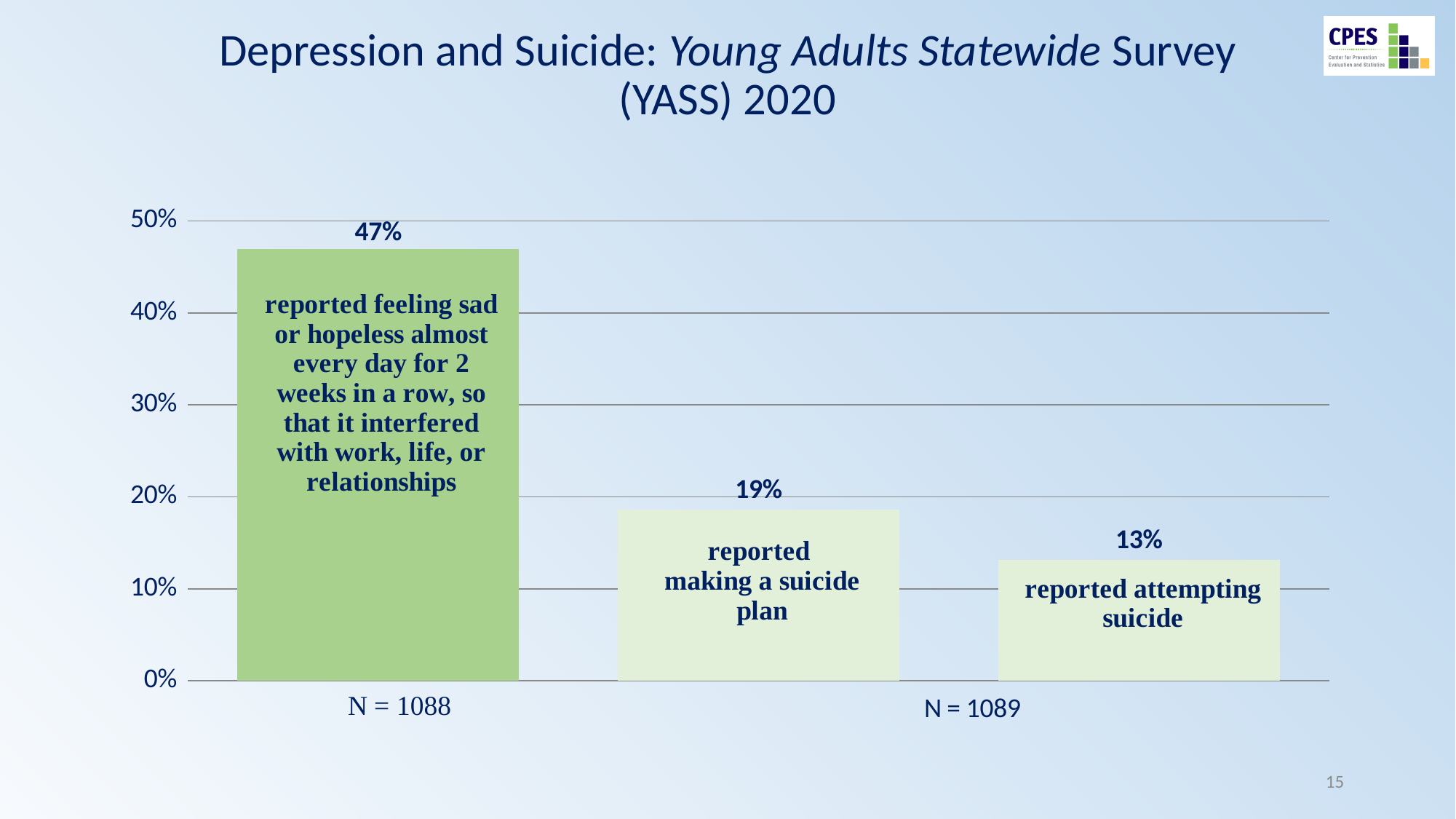
What is the sample size (N) shown under the first bar? N = 1088 What percentage of young adults reported attempting suicide? 13% What kind of chart is shown on the slide? bar chart What percentage of young adults reported making a suicide plan? 19% What percentage of young adults reported feeling sad or hopeless almost every day for 2 weeks in a row, so that it interfered with work, life, or relationships? 47% What is the difference in percentage points between those who reported making a suicide plan and those who reported attempting suicide? 6 What is the difference in percentage points between those who reported feeling sad or hopeless and those who reported making a suicide plan? 28 Which bar shows the lowest percentage? reported attempting suicide Which bar shows the highest percentage? reported feeling sad or hopeless almost every day for 2 weeks in a row, so that it interfered with work, life, or relationships Is the value for reported attempting suicide greater or less than 20%? less Which is larger: the percentage who reported making a suicide plan or the percentage who reported attempting suicide? reported making a suicide plan How many bars are shown in the chart? 3